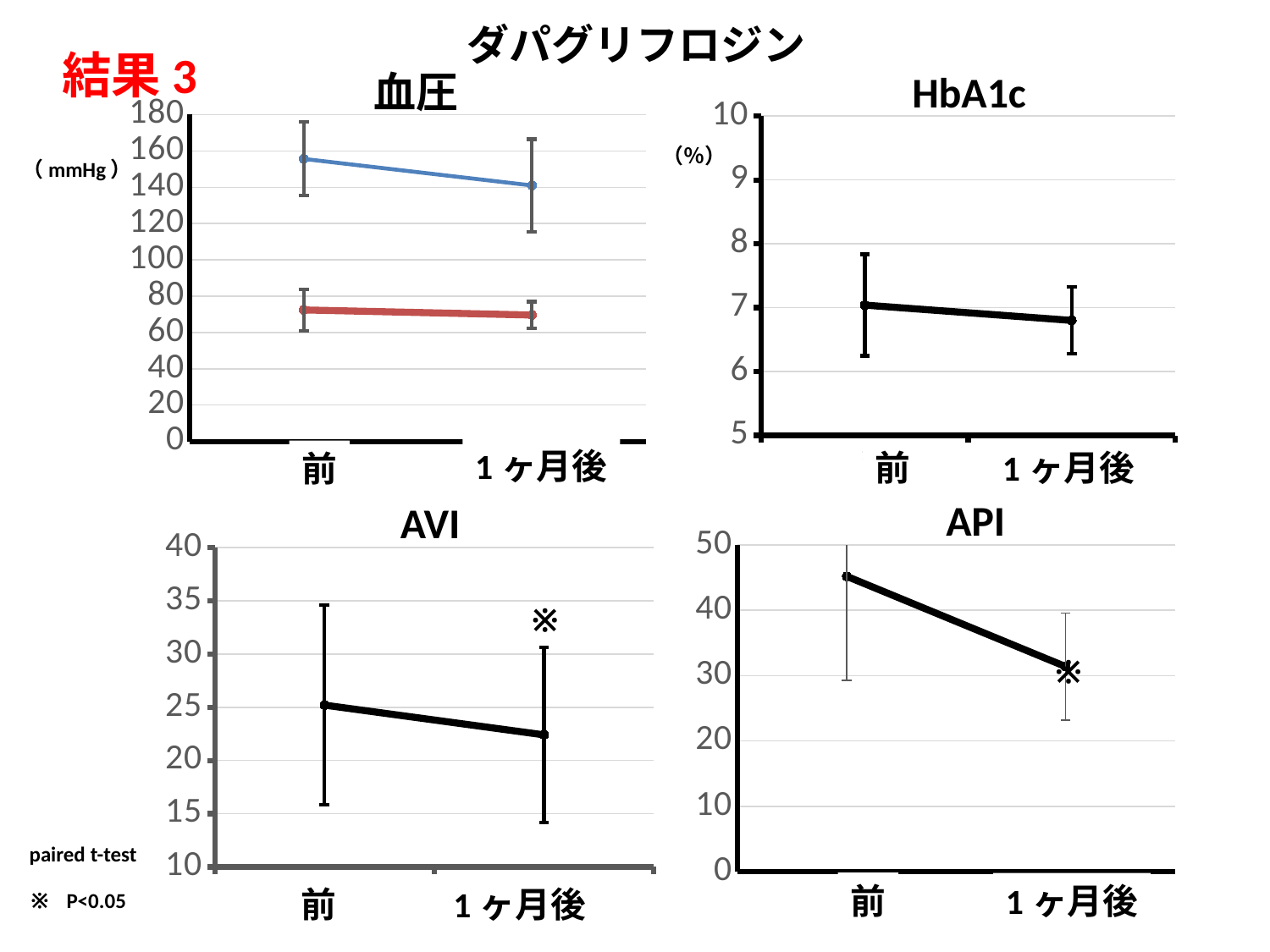
In the AVI chart, is the value at 前 greater or less than 20? greater In the API chart, which category has the higher value, 前 or 1ヶ月後? 前 In the AVI chart, does the value rise or fall from 前 to 1ヶ月後? fall How many x-axis categories does the HbA1c chart have? 2 In the HbA1c chart, does the value rise or fall from 前 to 1ヶ月後? fall In the 血圧 chart, which line has the larger value at 前, the blue line or the red line? the blue line In the 血圧 chart, is the value of the red line at 前 greater or less than 80? less In the API chart, is the value at 1ヶ月後 greater or less than 40? less What unit is shown on the y axis of the 血圧 chart? mmHg What kind of chart is the 血圧 chart? line chart